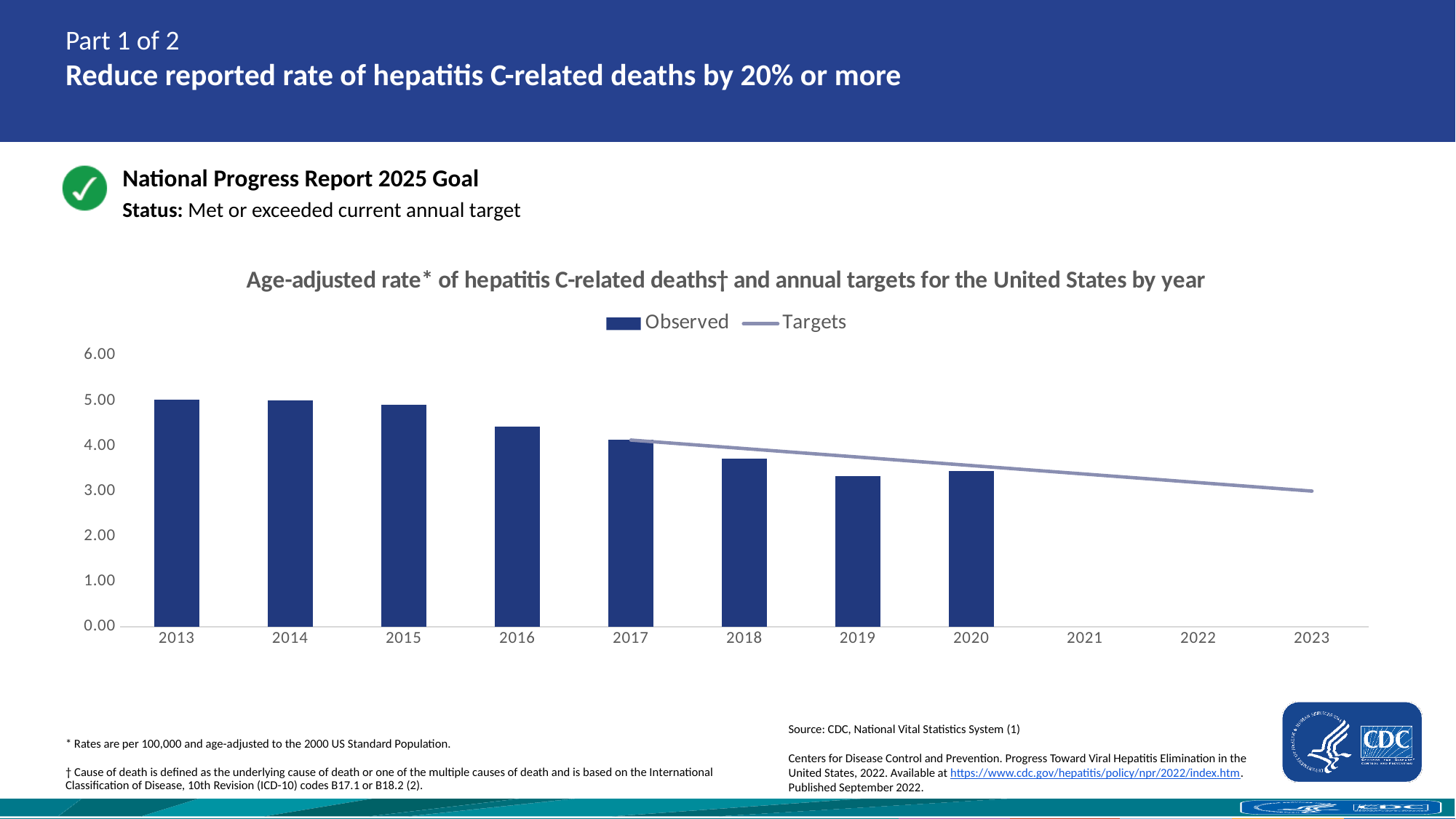
Which year has the larger Observed value, 2013 or 2018? 2013 How many series does the legend list? 2 How many years have an Observed bar plotted? 8 Do the Observed values generally rise or fall from 2013 to 2020? fall Is the Observed value for 2018 greater or less than 4.00? less Is the Observed value for 2019 greater or less than 3.00? greater What kind of chart is shown on the slide? Bar chart (with a target line) What are the two series named in the legend? Observed and Targets Is the Observed value for 2013 greater or less than 6.00? less What is the last year for which an Observed bar is plotted? 2020 How many year labels appear on the x axis? 11